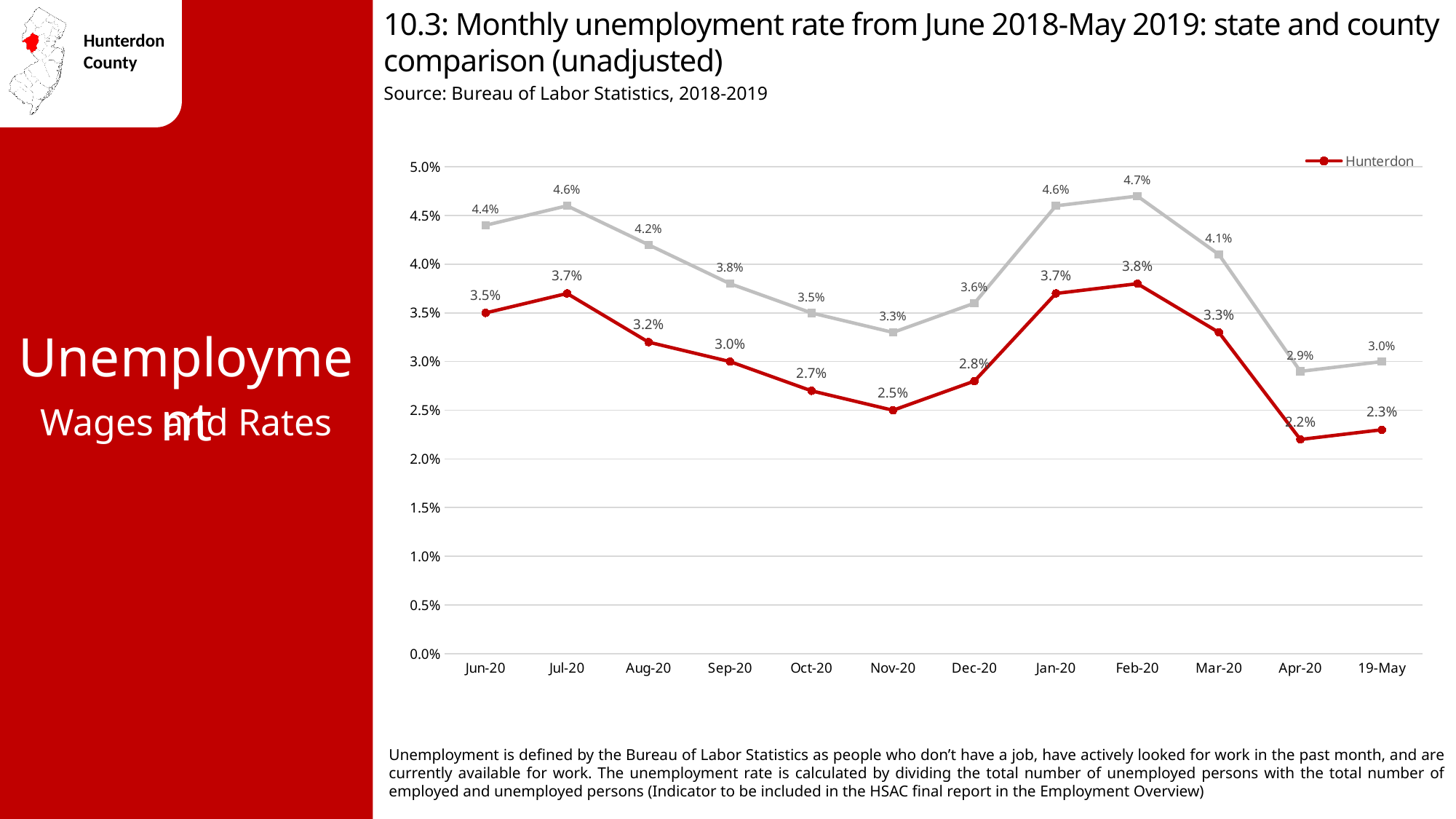
In which month does the Hunterdon line reach its lowest value? Apr-20 Which is higher for Hunterdon: the Jun-20 value or the Mar-20 value? Jun-20 What is the difference between the Hunterdon values for Jul-20 and Nov-20? 1.2 percentage points How many months are plotted along the x axis? 12 What is the Hunterdon unemployment rate for Nov-20? 2.5% What is the Hunterdon unemployment rate for Feb-20? 3.8% In which month does the Hunterdon line reach its highest value? Feb-20 What value does the gray (upper) line show for Jul-20? 4.6% Does the Hunterdon line rise or fall from Feb-20 to Apr-20? Falls In which month does the gray (upper) line reach its highest value? Feb-20 In Feb-20, how much higher is the gray line's value than the Hunterdon value? 0.9 percentage points What kind of chart is shown on the slide? Line chart